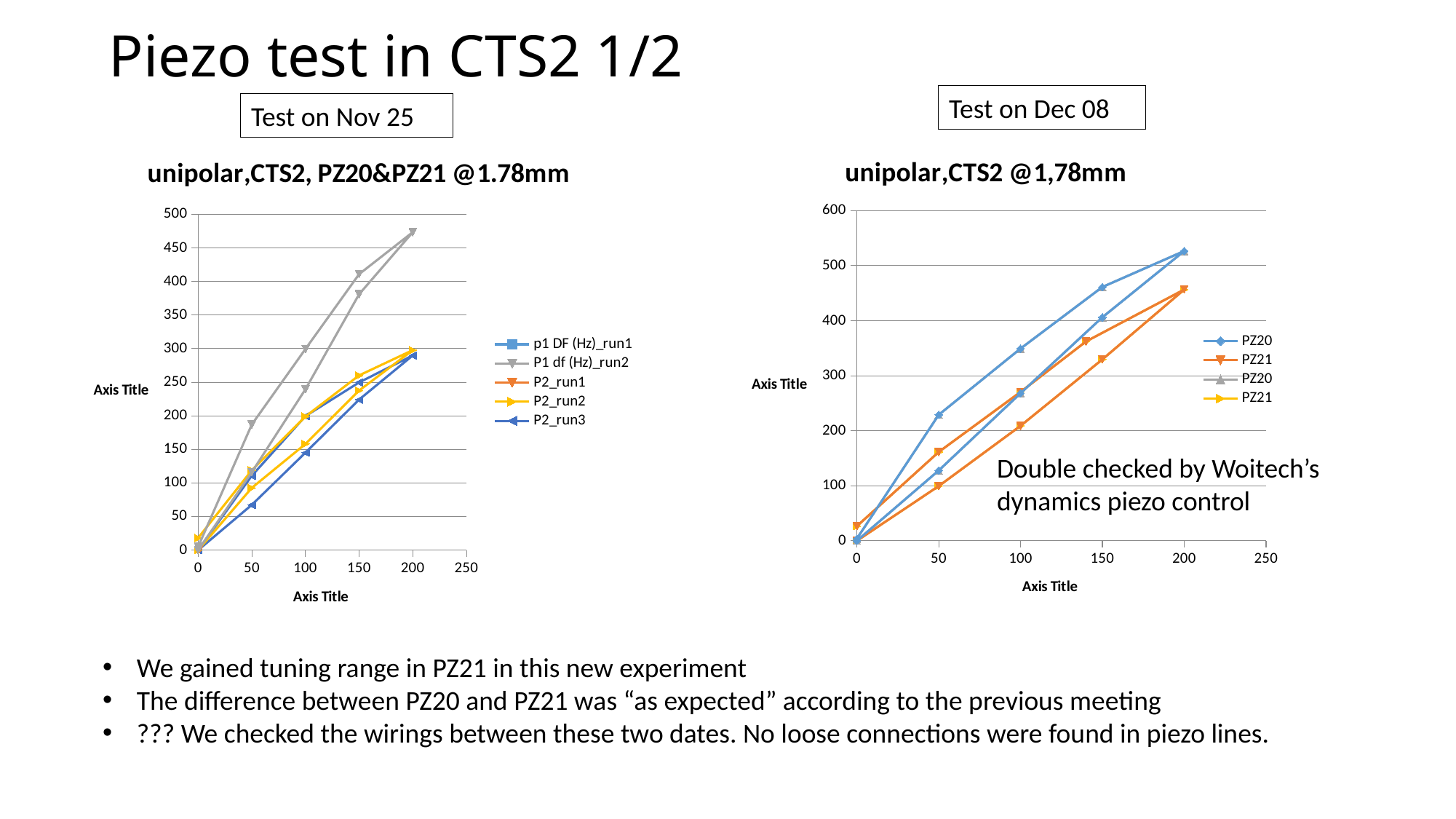
How many series does the legend of the left chart ("unipolar,CTS2, PZ20&PZ21 @1.78mm") list? 5 In the right chart ("unipolar,CTS2 @1,78mm"), do the PZ20 values rise or fall along the x axis? rise In the right chart ("unipolar,CTS2 @1,78mm"), is the value of PZ21 at x = 200 greater or less than 500? less In the right chart ("unipolar,CTS2 @1,78mm"), which series reaches the highest value at x = 200, PZ20 or PZ21? PZ20 In the left chart ("unipolar,CTS2, PZ20&PZ21 @1.78mm"), is the value of P1 df (Hz)_run2 at x = 200 greater or less than 450? greater In the right chart ("unipolar,CTS2 @1,78mm"), is the value of PZ20 at x = 200 greater or less than 500? greater What kind of chart is the left chart titled "unipolar,CTS2, PZ20&PZ21 @1.78mm"? line chart How many series does the legend of the right chart ("unipolar,CTS2 @1,78mm") list? 4 In the left chart ("unipolar,CTS2, PZ20&PZ21 @1.78mm"), do the series values rise or fall as the x value increases from 0 to 200? rise What is the title of the right chart on the slide? unipolar,CTS2 @1,78mm